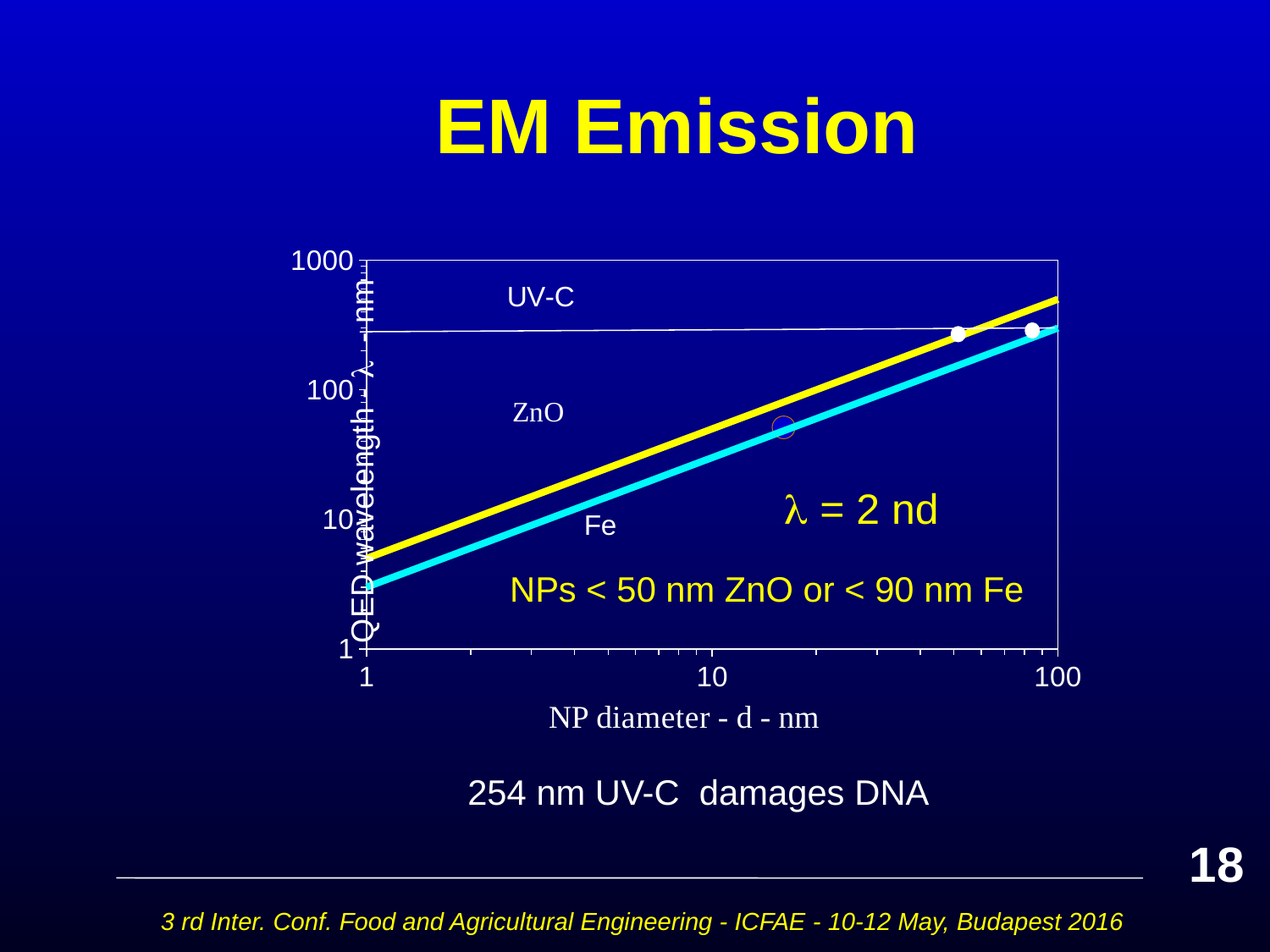
What is the label of the x axis of the chart? NP diameter - d - nm How many material lines (ZnO and Fe) are plotted on the chart? 2 Is the QED wavelength for ZnO at an NP diameter of 100 nm greater or less than 100? greater Is the QED wavelength for Fe at an NP diameter of 1 nm greater or less than 10? less Do the ZnO and Fe lines rise or fall as NP diameter increases? Rise At an NP diameter of 10 nm, which line has the higher QED wavelength, ZnO or Fe? ZnO Is the QED wavelength for Fe at an NP diameter of 10 nm greater or less than 10? greater What is the highest value shown on the y axis of the chart? 1000 What kind of chart is shown on the slide? Line chart What wavelength does the horizontal UV-C line on the chart correspond to, according to the slide? 254 nm What is the title of the slide containing the chart? EM Emission